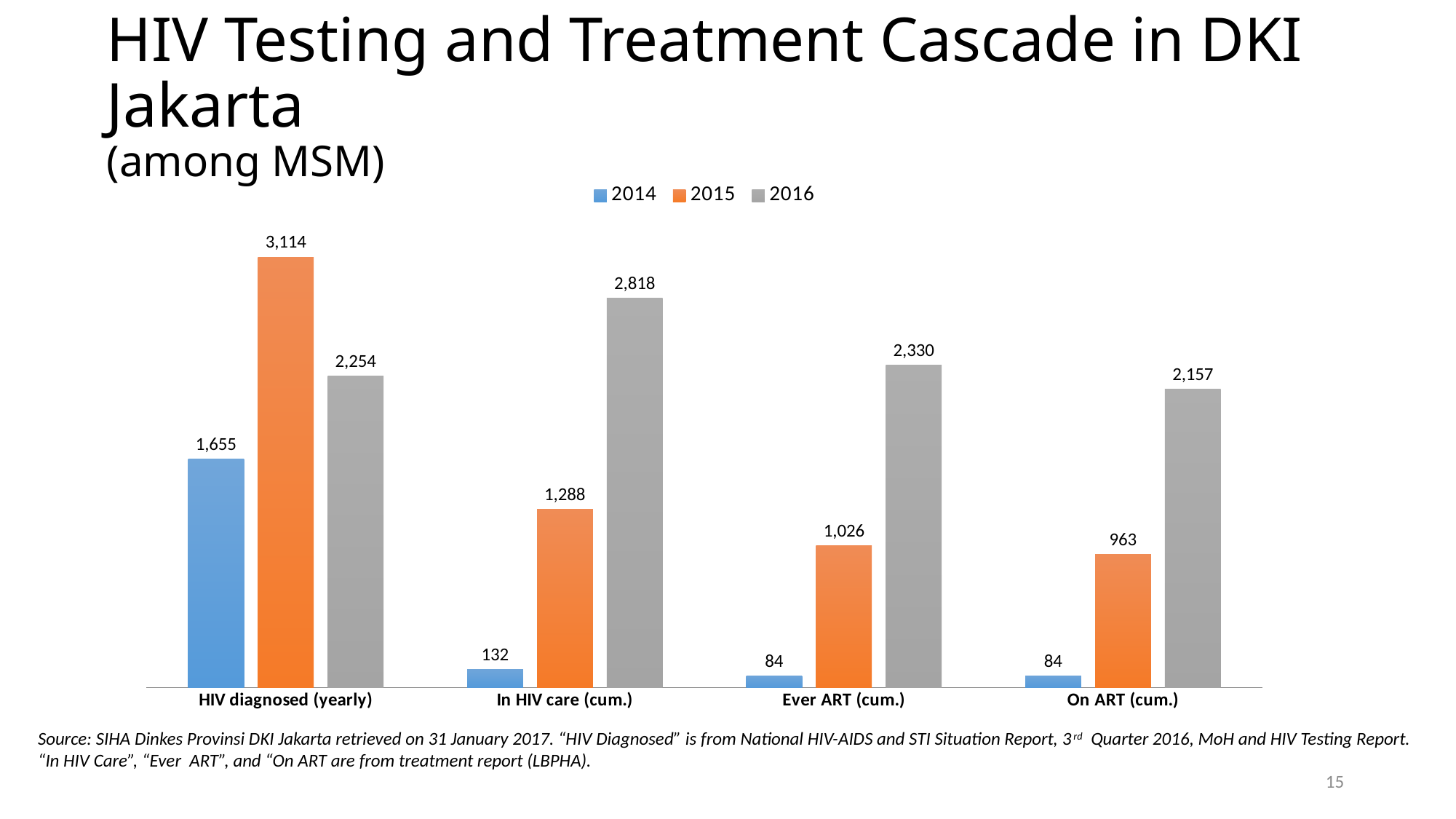
What is the 2015 value for Ever ART (cum.)? 1,026 How many series does the legend list? 3 How many categories are shown on the x axis? 4 Which category has the lowest 2015 value? On ART (cum.) Which is larger: the 2014 value for HIV diagnosed (yearly) or the 2015 value for In HIV care (cum.)? 2014 value for HIV diagnosed (yearly) What is the 2016 value for In HIV care (cum.)? 2,818 What is the 2014 value for On ART (cum.)? 84 What is the difference between the 2015 and 2016 values for HIV diagnosed (yearly)? 860 Which category has the highest 2016 value? In HIV care (cum.) What is the difference between the 2016 values for Ever ART (cum.) and On ART (cum.)? 173 What kind of chart is shown on the slide? Bar chart What is the 2015 value for HIV diagnosed (yearly)? 3,114